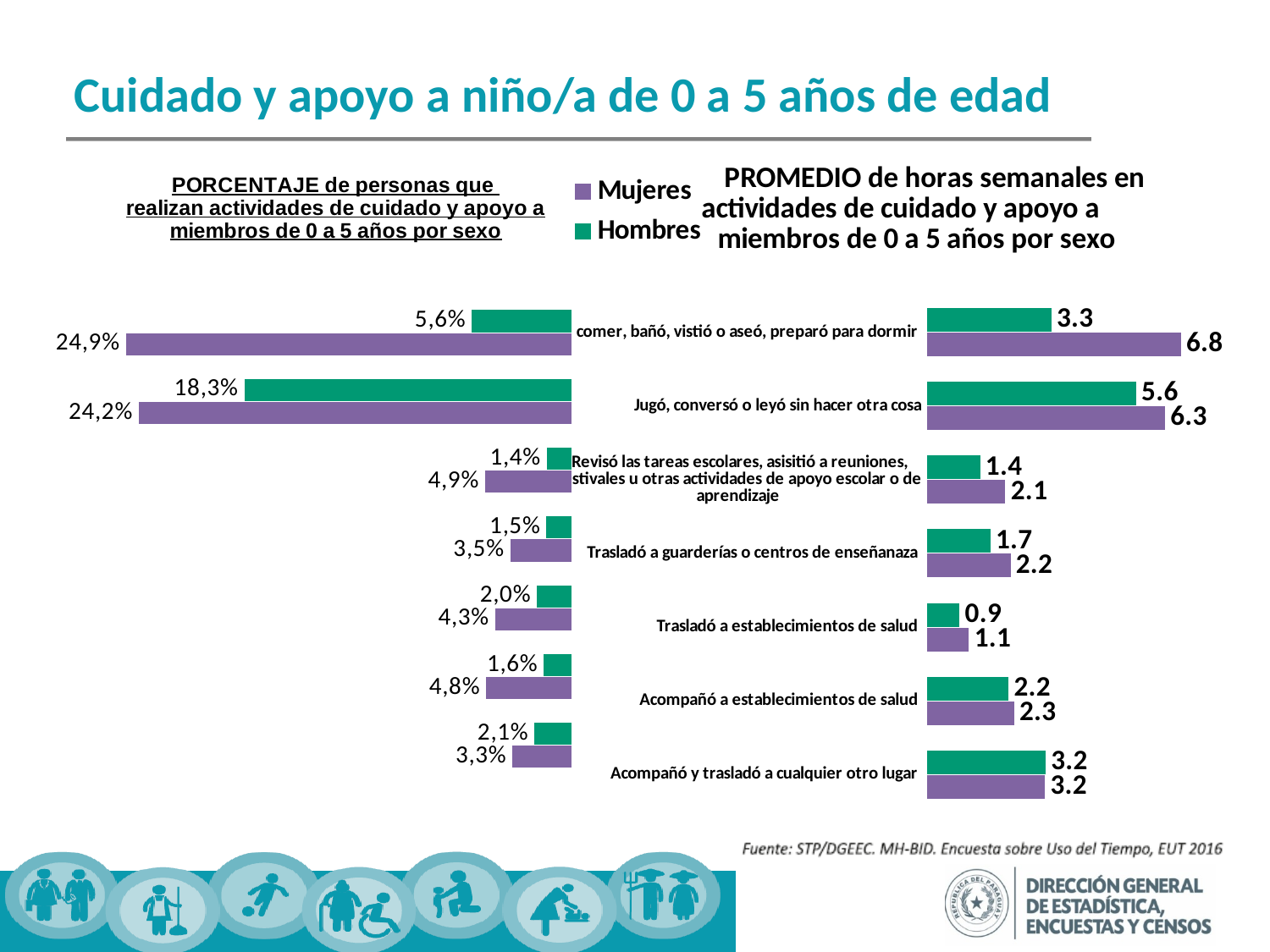
In the PROMEDIO de horas semanales chart, what is the difference between Mujeres and Hombres for 'Jugó, conversó o leyó sin hacer otra cosa'? 0.7 In the PORCENTAJE chart, what is the difference between Mujeres and Hombres for 'comer, bañó, vistió o aseó, preparó para dormir'? 19,3% How many activity categories are shown in the PROMEDIO de horas semanales chart? 7 How many series does the legend list? 2 In the PROMEDIO de horas semanales chart, what is the value for Hombres for 'Trasladó a establecimientos de salud'? 0.9 In the PORCENTAJE chart, what percentage of Mujeres realizan 'comer, bañó, vistió o aseó, preparó para dormir'? 24,9% In the PROMEDIO de horas semanales chart, which activity has the highest value for Mujeres? comer, bañó, vistió o aseó, preparó para dormir What type of chart is the PORCENTAJE chart? Bar chart In the PORCENTAJE chart, which activity has the lowest value for Hombres? Revisó las tareas escolares, asistió a reuniones, festivales u otras actividades de apoyo escolar o de aprendizaje In the PROMEDIO de horas semanales chart, what is the value for Mujeres for 'comer, bañó, vistió o aseó, preparó para dormir'? 6.8 In the PORCENTAJE chart, what is the value for Hombres for 'Jugó, conversó o leyó sin hacer otra cosa'? 18,3% In the PORCENTAJE chart, which is larger for 'Trasladó a guarderías o centros de enseñanaza': Mujeres or Hombres? Mujeres